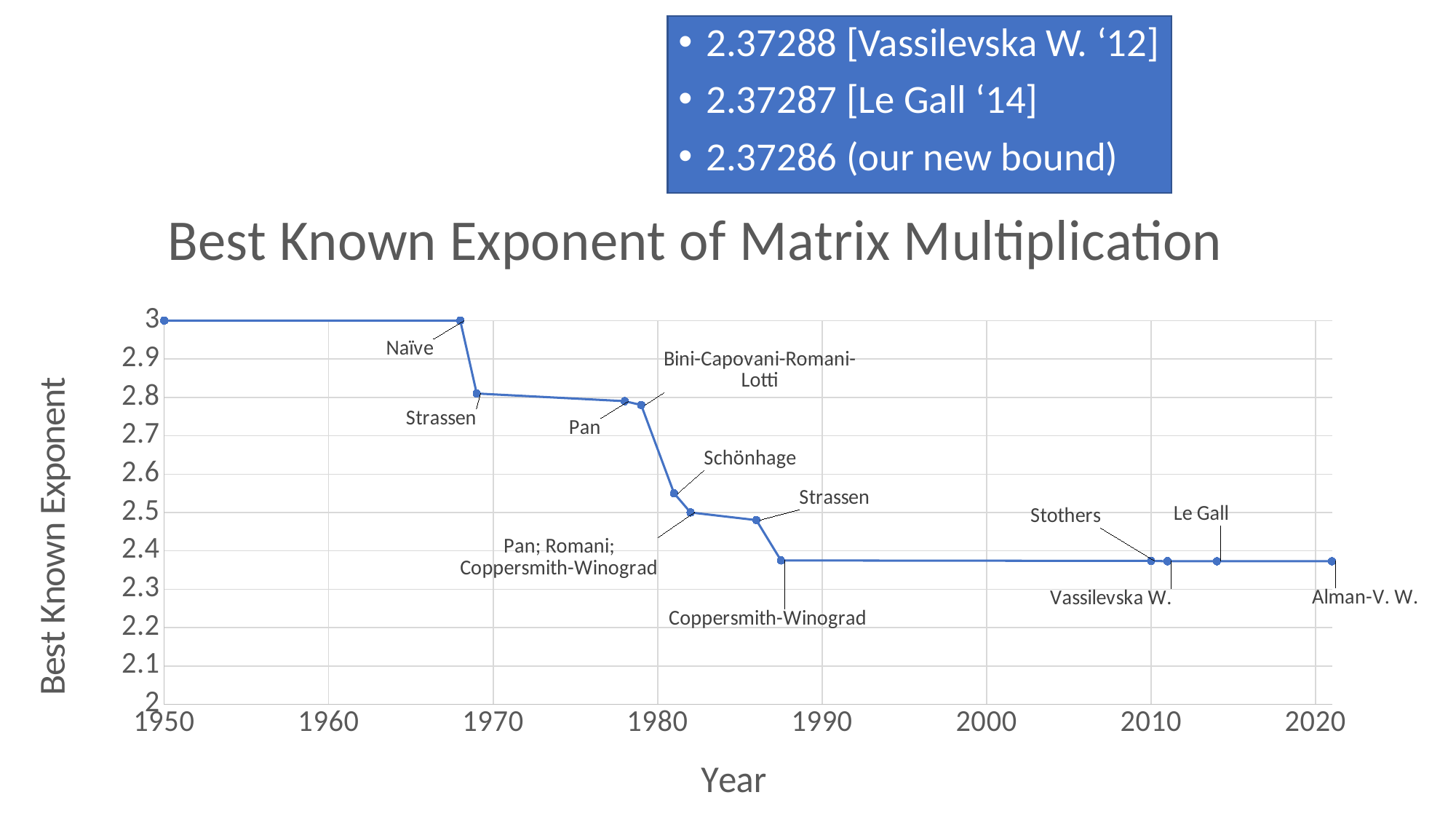
Do the values rise or fall as the year increases along the x axis? fall Is the value for the point labelled Schönhage greater or less than 2.6? less Is the value for the point labelled Strassen (around 1969) greater or less than 2.9? less Which labelled point has the highest Best Known Exponent? Naïve How many data points are plotted on the line? 13 What kind of chart is shown on the slide? line chart What is the value of the Best Known Exponent for the point labelled Naïve? 3 Is the value for the point labelled Le Gall greater or less than 2.5? less What is the label of the x axis? Year Which has the larger Best Known Exponent, the point labelled Pan or the point labelled Schönhage? Pan What is the title of the chart? Best Known Exponent of Matrix Multiplication